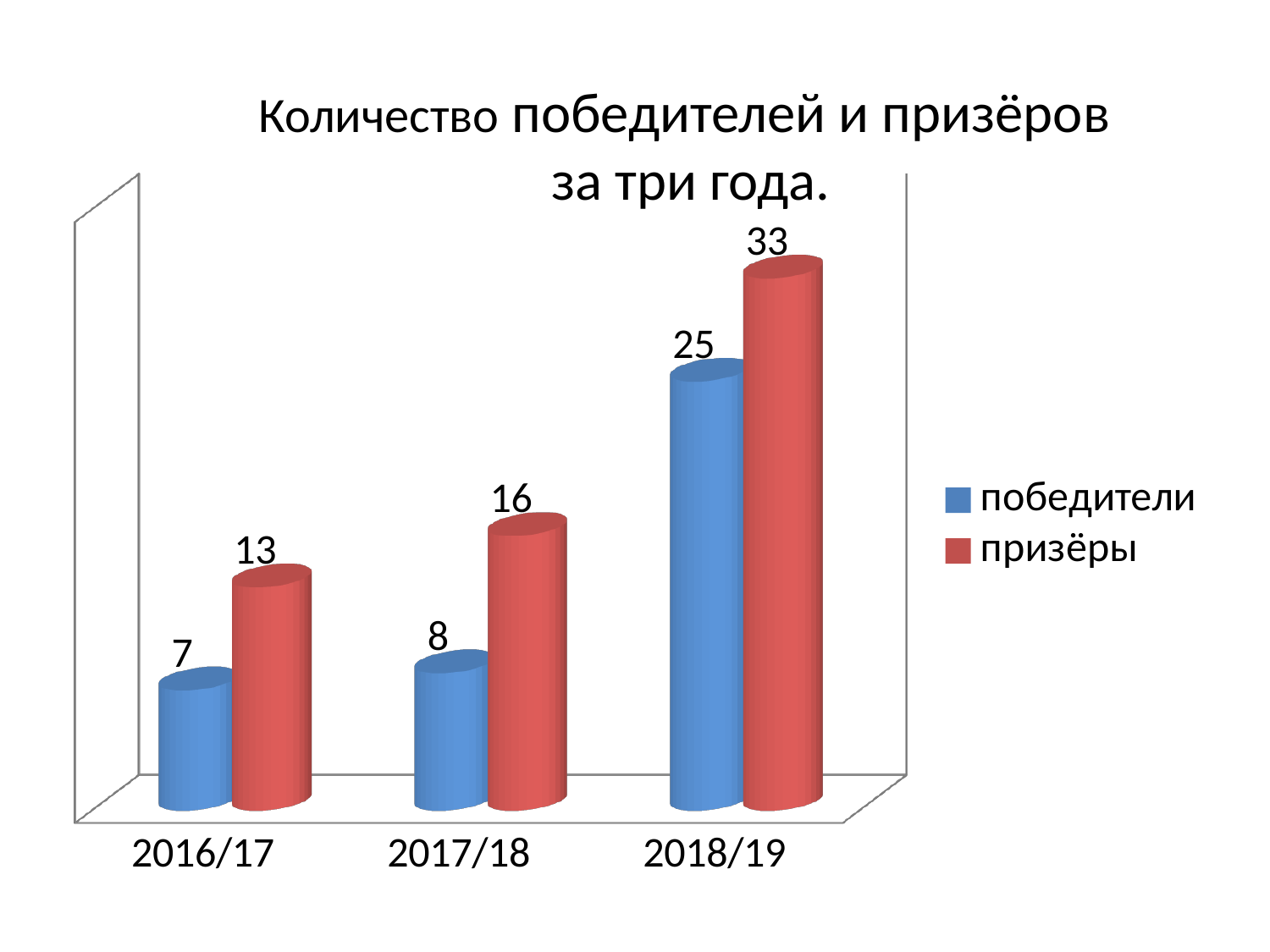
How many series does the legend list? 2 What is the difference between призёры and победители in 2018/19? 8 What is the value for призёры in 2018/19? 33 In which year is the value for призёры highest? 2018/19 Which is larger in 2017/18, победители or призёры? призёры What is the value for призёры in 2017/18? 16 What is the value for победители in 2016/17? 7 Do the values for победители rise or fall from 2016/17 to 2018/19? rise What is the difference between призёры in 2017/18 and призёры in 2016/17? 3 How many years are shown on the x axis? 3 What is the value for победители in 2018/19? 25 In which year is the value for победители lowest? 2016/17